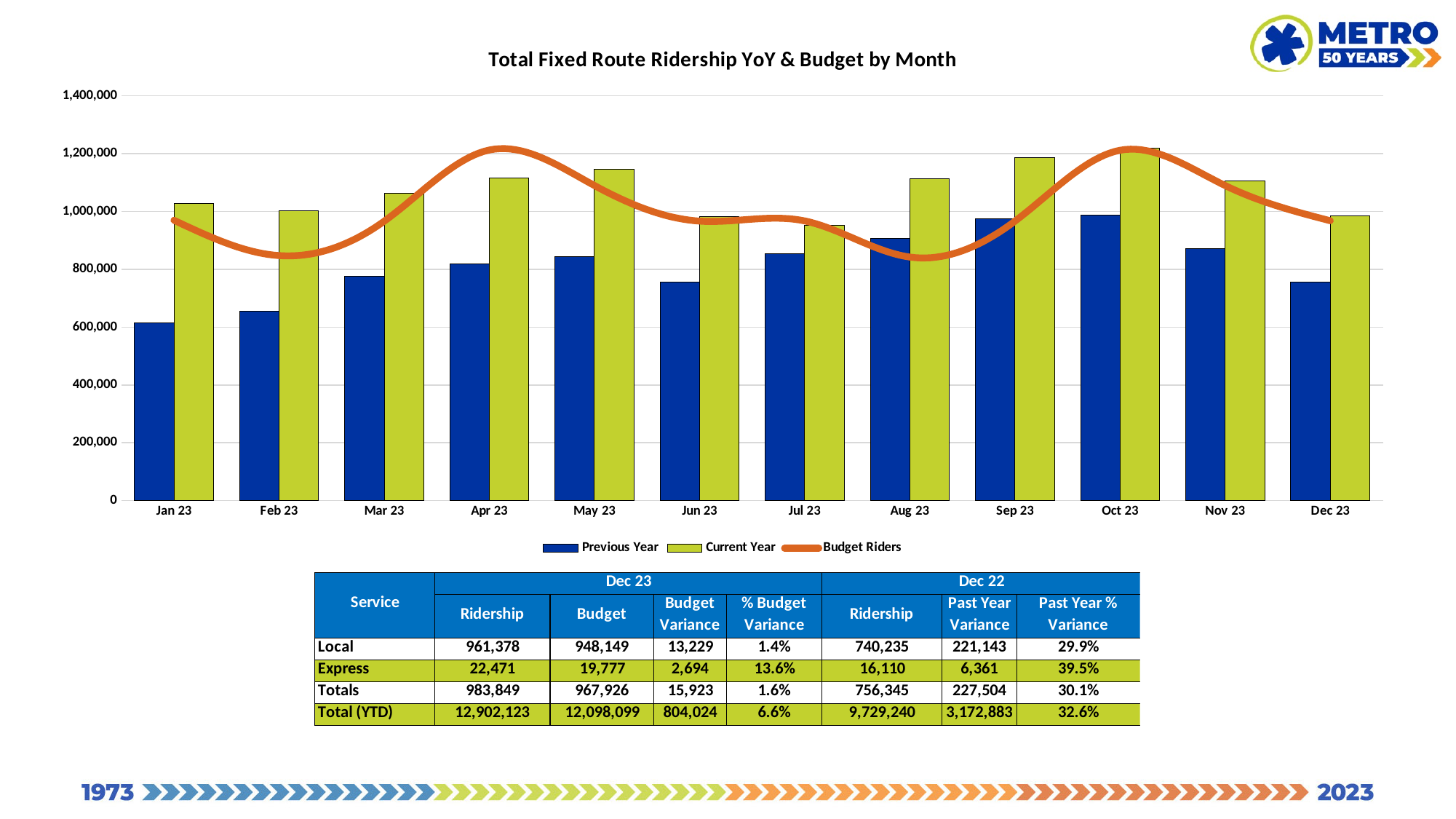
Which month has the lowest Previous Year value? Jan 23 How many series does the chart legend list? 3 Is the Previous Year value for Feb 23 greater or less than 800,000? less What kind of chart is used for the Previous Year and Current Year series? Bar chart Is the Current Year value for Sep 23 greater or less than 1,000,000? greater What is the title of the chart? Total Fixed Route Ridership YoY & Budget by Month Which month has the highest Current Year value? Oct 23 What colour is the Budget Riders line in the chart? Orange Do the Previous Year values rise or fall from Jan 23 to May 23? rise In Jan 23, which is larger: the Previous Year value or the Current Year value? Current Year How many months are shown on the x axis of the chart? 12 Is the Current Year value for Jul 23 greater or less than 1,000,000? less